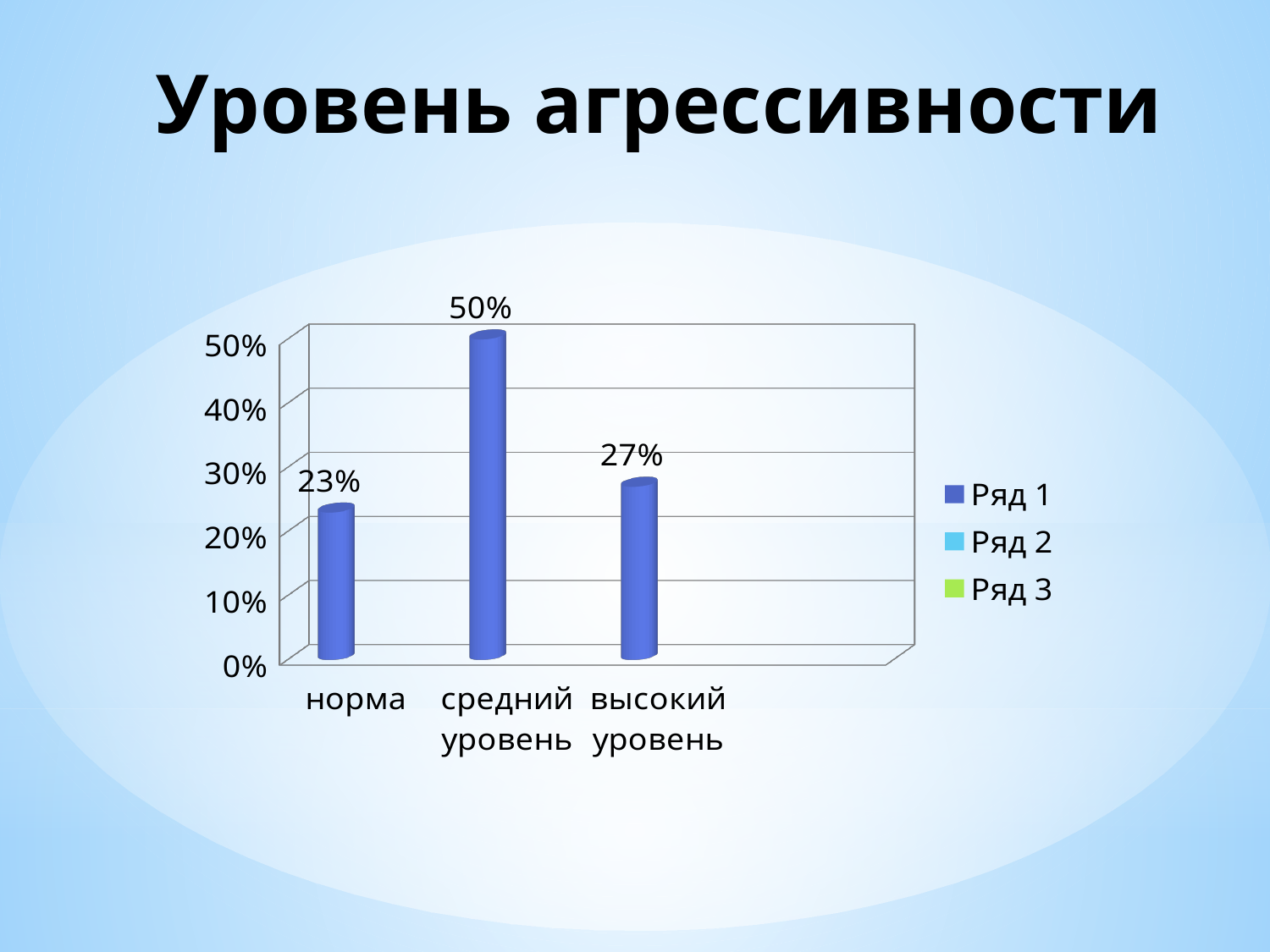
What is the difference between the values for высокий уровень and норма? 4% What kind of chart is shown on the slide? bar chart Which is larger, the value for высокий уровень or the value for норма? высокий уровень How many categories are shown on the x axis? 3 What is the difference between the values for средний уровень and норма? 27% What is the value for средний уровень? 50% What is the value for высокий уровень? 27% Which category has the lowest value? норма Which category has the highest value? средний уровень What is the value for норма? 23% How many series does the legend list? 3 Is the value for средний уровень greater or less than 40%? greater